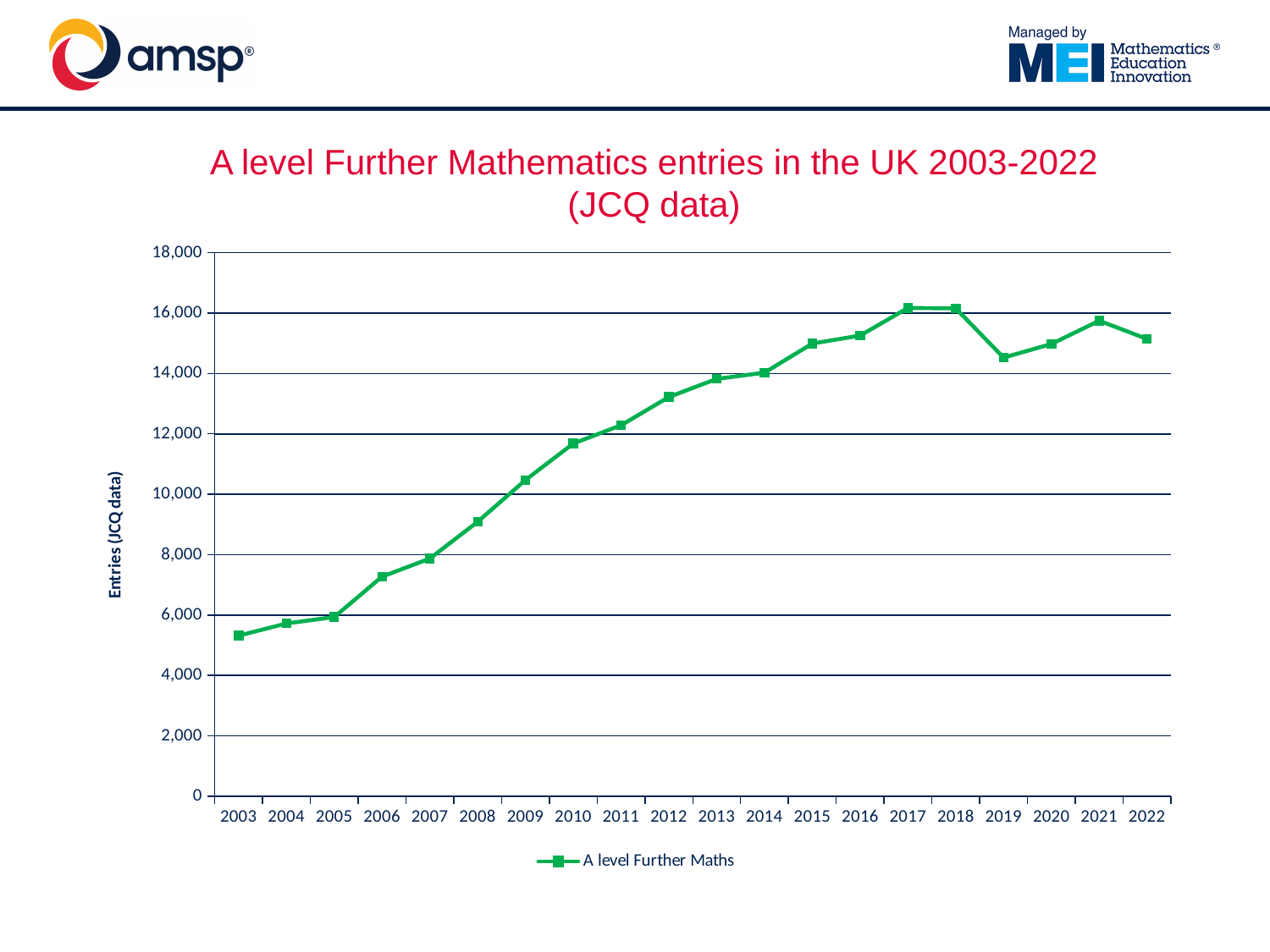
How many series does the legend list? 1 What kind of chart is shown on the slide? line chart Overall, do A level Further Maths entries rise or fall from 2003 to 2022? rise Is the value for 2010 greater or less than 12,000? less Is the value for 2003 greater or less than 6,000? less How many years are plotted along the x axis? 20 Which year has more A level Further Maths entries, 2019 or 2021? 2021 Which year has the lowest number of A level Further Maths entries? 2003 Which year has more A level Further Maths entries, 2010 or 2015? 2015 Is the value for 2008 greater or less than 8,000? greater What is the label on the y axis of the chart? Entries (JCQ data)